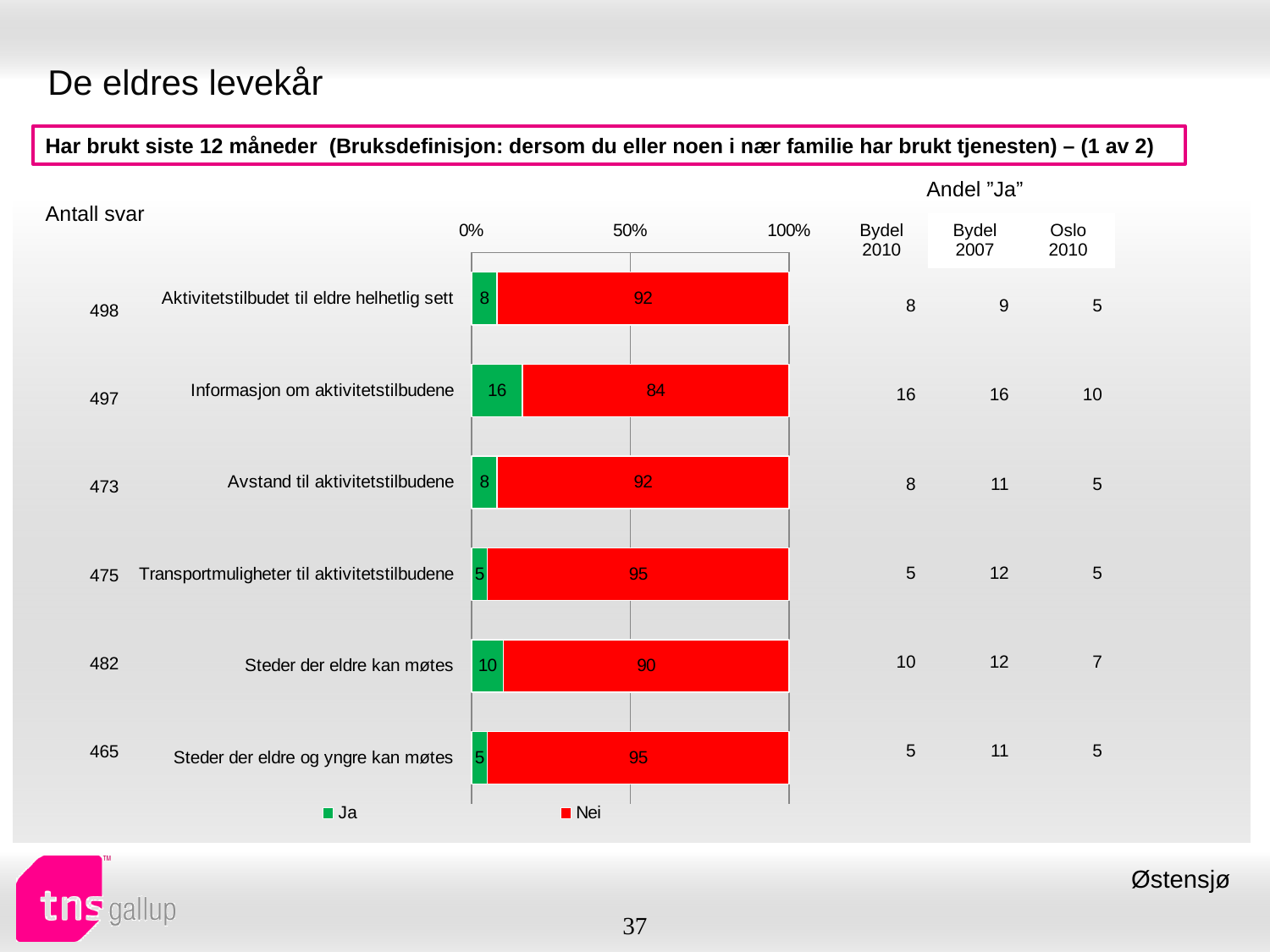
What is the "Nei" value for "Transportmuligheter til aktivitetstilbudene"? 95 How many categories are shown in the chart? 6 Which category has the highest "Ja" value? Informasjon om aktivitetstilbudene What is the total of the stacked bar for "Steder der eldre kan møtes"? 100 Which is larger: the "Ja" value for "Steder der eldre kan møtes" or for "Avstand til aktivitetstilbudene"? Steder der eldre kan møtes What is the "Ja" value for "Informasjon om aktivitetstilbudene"? 16 What kind of chart is shown on the slide? Stacked bar chart How many series does the legend list? 2 Is the "Nei" value for "Steder der eldre og yngre kan møtes" greater or less than 50%? greater What is the "Nei" value for "Steder der eldre kan møtes"? 90 What is the difference between the "Nei" values for "Aktivitetstilbudet til eldre helhetlig sett" and "Informasjon om aktivitetstilbudene"? 8 Which category has the lowest "Nei" value? Informasjon om aktivitetstilbudene